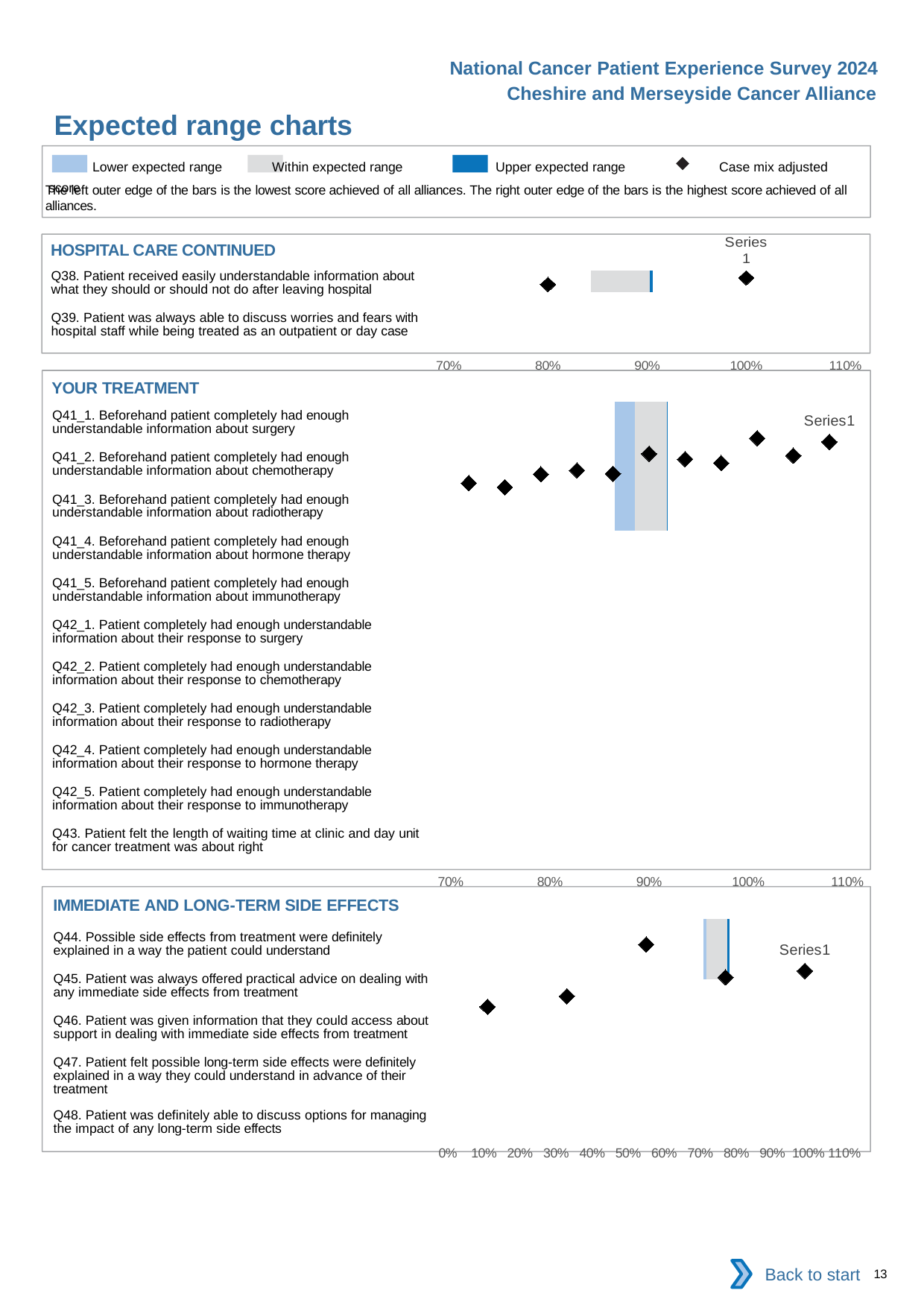
How many charts are shown on the slide? 3 In the Your Treatment chart, is the value for the leftmost plotted diamond greater or less than 80%? less How many series does the legend list in the Immediate and Long-term Side Effects chart? 1 What is the name of the legend entry shown in the Immediate and Long-term Side Effects chart? Series1 In the Immediate and Long-term Side Effects chart, is the value for the leftmost plotted diamond greater or less than 50%? less How many series does the legend list in the Your Treatment chart? 1